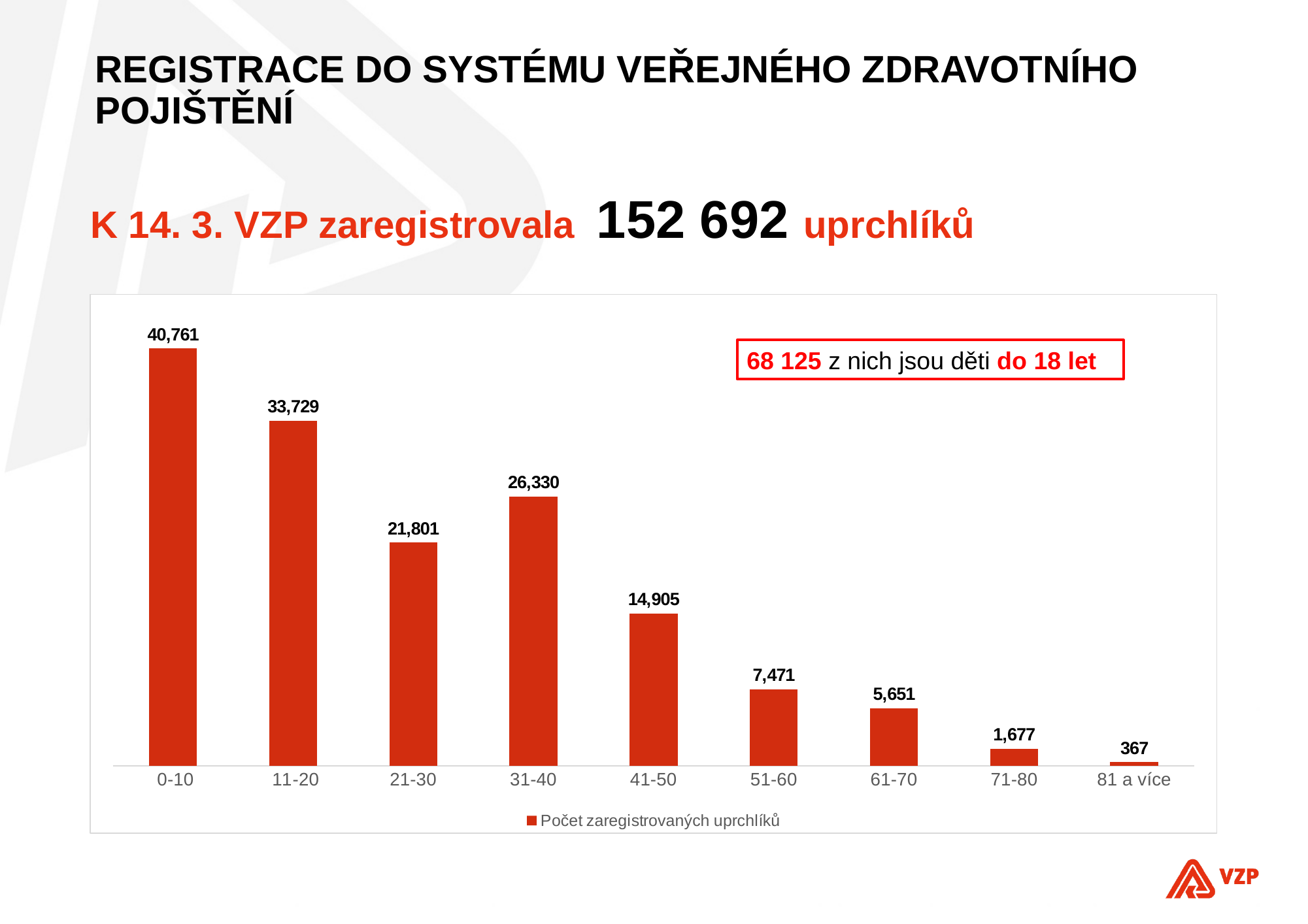
Which age group has the highest number of registered refugees? 0-10 Do the values generally rise or fall from the 31-40 group to the 81 a více group? fall Which is larger, the value for 21-30 or the value for 31-40? 31-40 What is the value for the 0-10 age group? 40,761 What is the legend entry for the series shown? Počet zaregistrovaných uprchlíků How many age groups are shown on the x axis? 9 How many series does the legend list? 1 What kind of chart is shown on the slide? bar chart What is the value for the 41-50 age group? 14,905 What is the value for the 81 a více age group? 367 Which age group has the lowest number of registered refugees? 81 a více What is the difference between the values for 11-20 and 21-30? 11,928